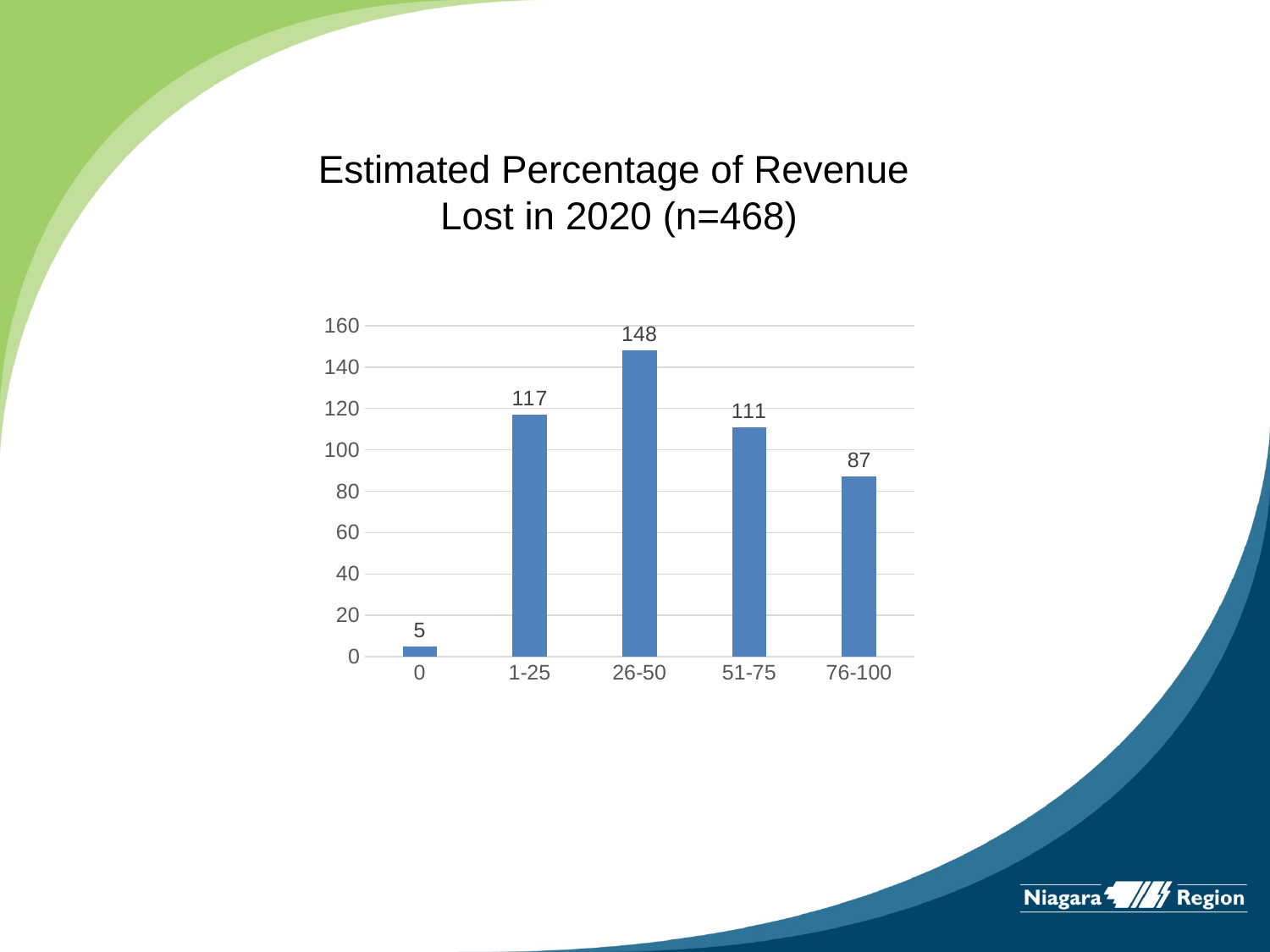
What is the value for the 0 category? 5 What kind of chart is shown on the slide? bar chart What is the value for the 76-100 category? 87 What is the difference between the values for 26-50 and 1-25? 31 Is the value for 76-100 greater or less than 100? less Which is larger, the value for 1-25 or the value for 51-75? 1-25 What is the difference between the values for 51-75 and 76-100? 24 What is the title of the chart? Estimated Percentage of Revenue Lost in 2020 (n=468) Which category has the highest value? 26-50 How many categories are shown on the x axis? 5 Which category has the lowest value? 0 What is the value for the 26-50 category? 148